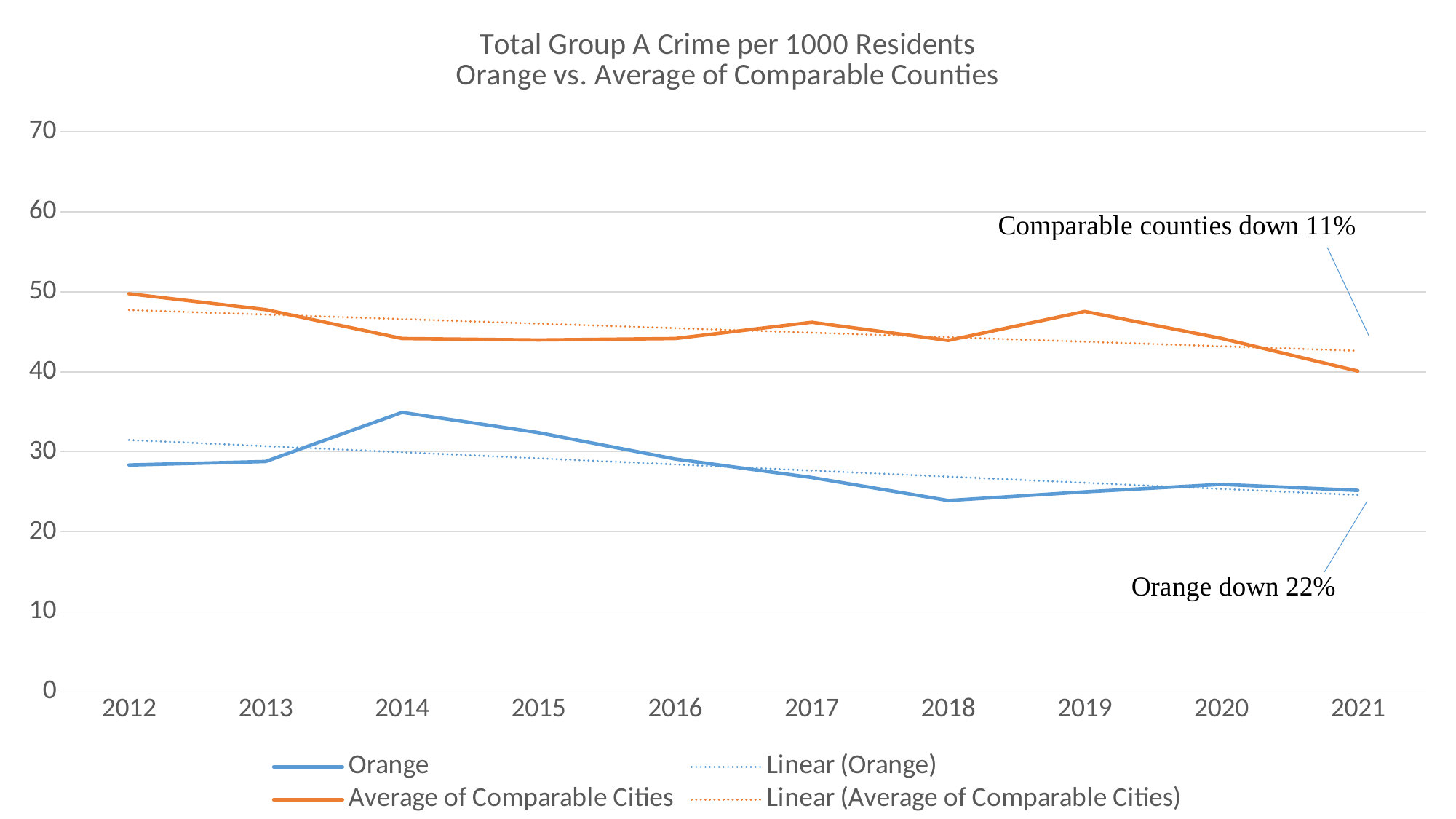
Is the Average of Comparable Cities value for 2021 greater or less than 50? less In 2012, which is larger: the Orange value or the Average of Comparable Cities value? Average of Comparable Cities In which year does the Orange series reach its highest value? 2014 In which year is the Average of Comparable Cities series at its highest? 2012 In which year is the Average of Comparable Cities series at its lowest? 2021 How many years are plotted along the x axis? 10 Does the Orange series rise or fall between 2014 and 2018? fall What kind of chart is shown on the slide? line chart According to the annotation on the chart, by what percentage is Orange down? 22% In which year does the Orange series reach its lowest value? 2018 How many series does the legend list? 4 Is the Orange value for 2014 greater or less than 30? greater